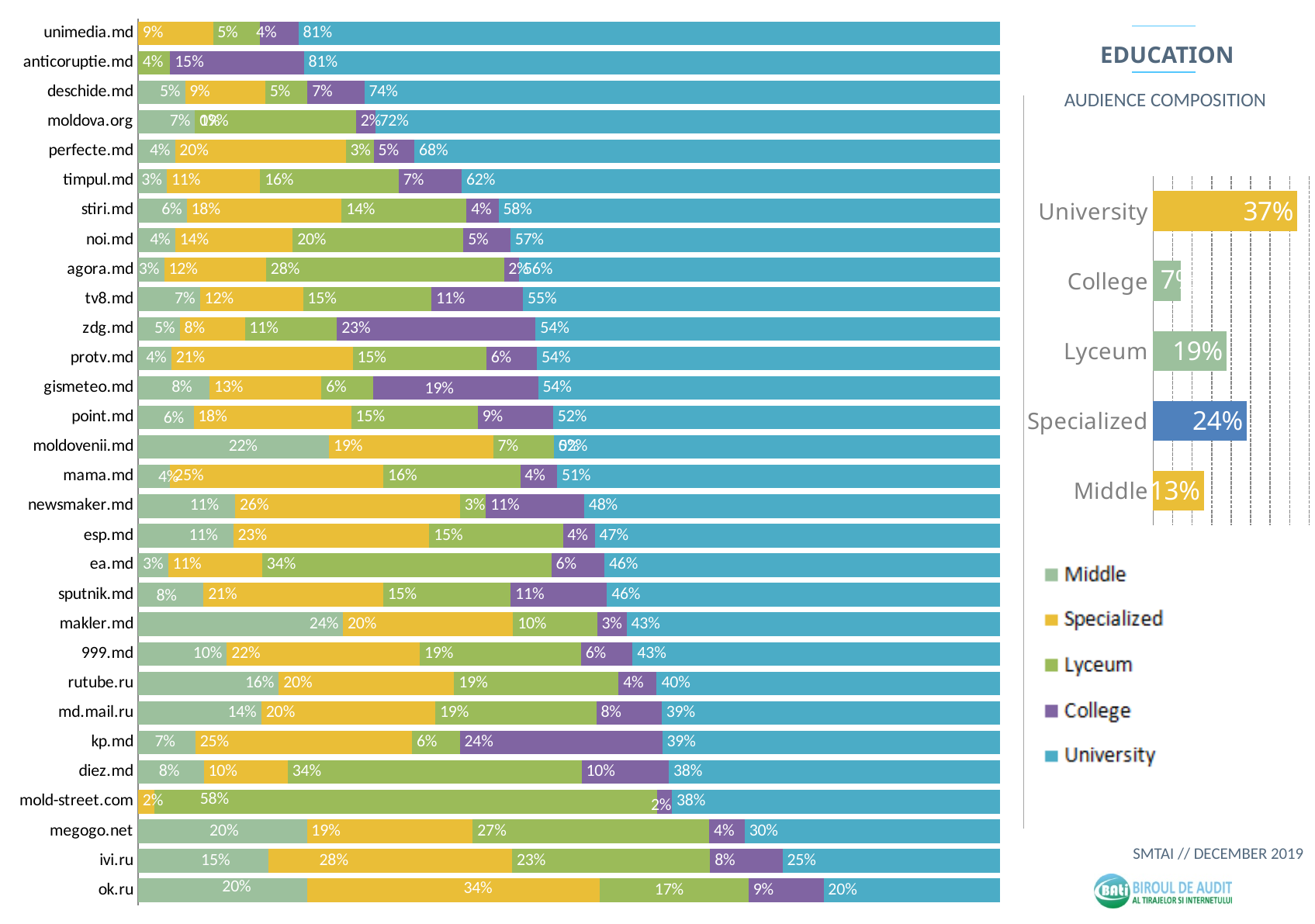
In the Audience Composition chart on the right, which education level has the highest value? University In the large stacked chart on the left, what is the Lyceum share for mold-street.com? 58% In the Audience Composition chart on the right, what is the difference between the University and Specialized values? 13% In the Audience Composition chart on the right, which education level has the lowest value? College In the large stacked chart on the left, what is the University share for unimedia.md? 81% In the Audience Composition chart on the right, what is the value for University? 37% What kind of chart is the large chart on the left? Stacked bar chart How many series does the legend of the large stacked chart on the left list? 5 In the large stacked chart on the left, which has the larger College share, zdg.md or protv.md? zdg.md In the large stacked chart on the left, what is the difference between the Specialized and Lyceum shares for ok.ru? 17% In the large stacked chart on the left, which website has the lowest University share? ok.ru In the Audience Composition chart on the right, how many education levels are shown? 5